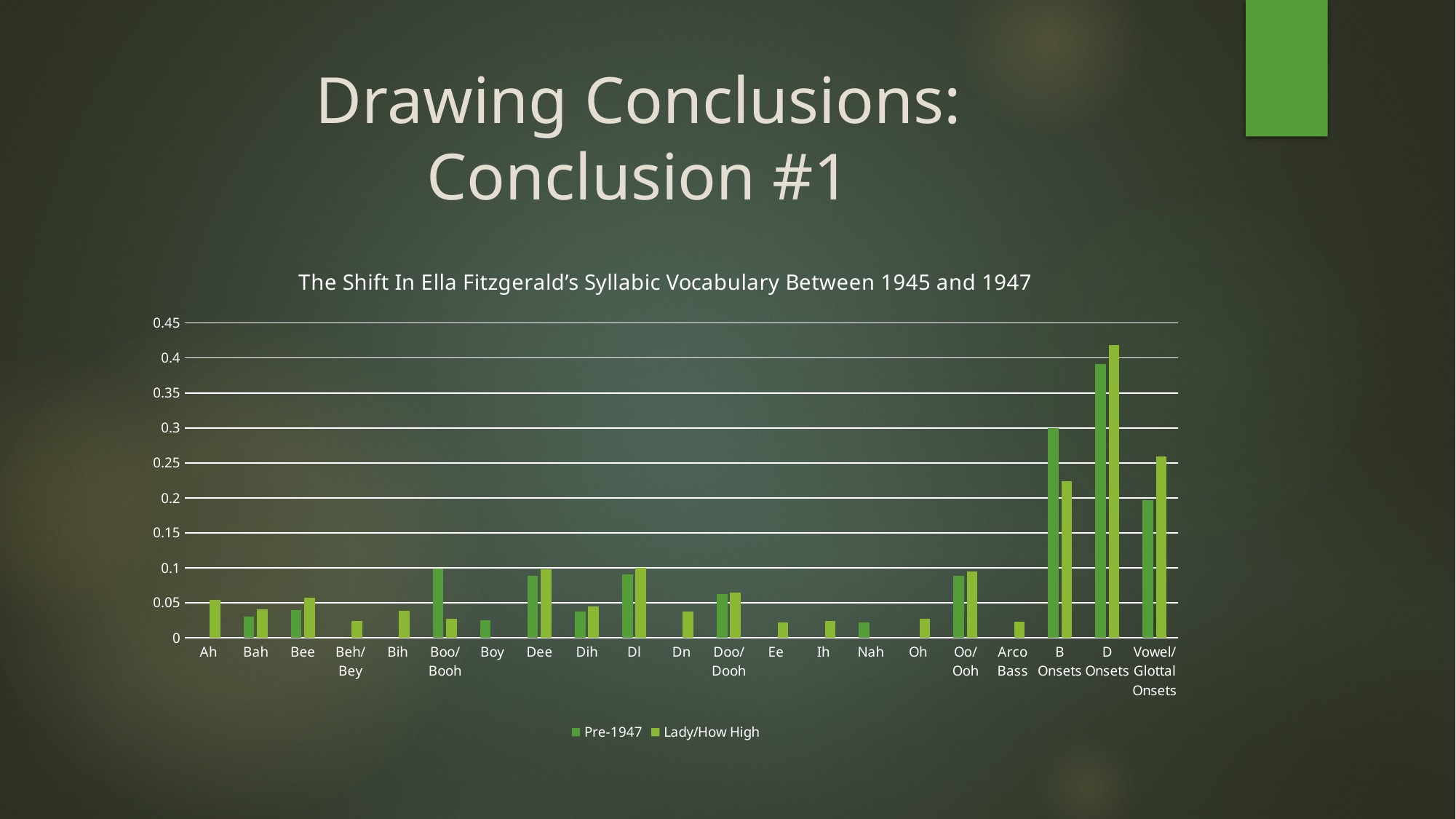
How many series does the legend list? 2 Is the Lady/How High value for B Onsets greater or less than 0.2? greater Which category has the highest value for the Lady/How High series? D Onsets How many categories are shown on the x axis? 21 For B Onsets, which series has the larger value, Pre-1947 or Lady/How High? Pre-1947 What is the title of the chart? The Shift In Ella Fitzgerald's Syllabic Vocabulary Between 1945 and 1947 Is the Pre-1947 value for D Onsets greater or less than 0.35? greater For Boo/Booh, which series has the larger value, Pre-1947 or Lady/How High? Pre-1947 Is the Lady/How High value for D Onsets greater or less than 0.4? greater What type of chart is shown on the slide? Bar chart Which category has the highest value for the Pre-1947 series? D Onsets What are the two series named in the legend? Pre-1947 and Lady/How High